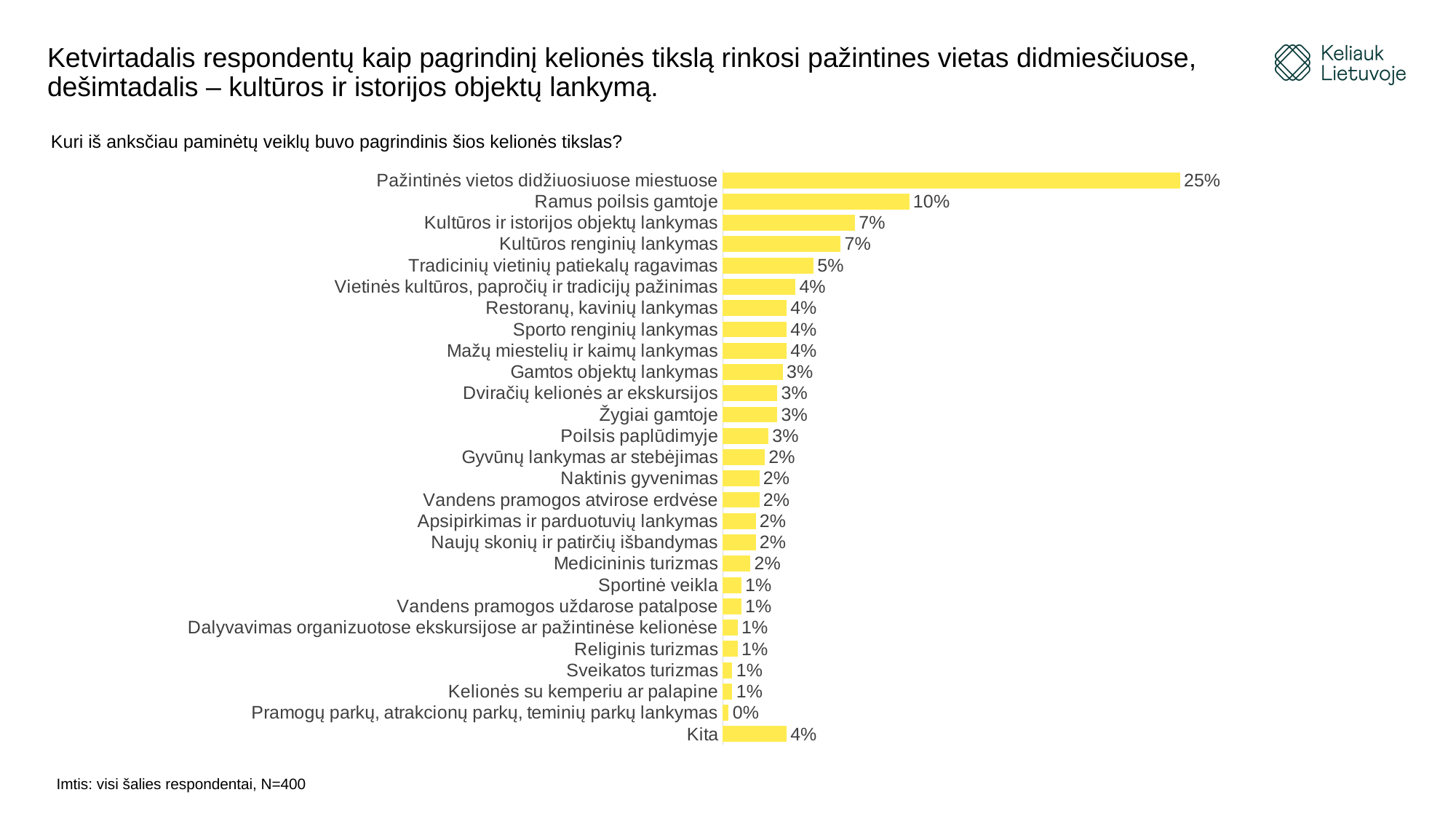
What is the value for Ramus poilsis gamtoje? 10% How many categories are shown in the chart? 27 What is the value for Kita? 4% What is the value for Pažintinės vietos didžiuosiuose miestuose? 25% What is the value for Medicininis turizmas? 2% What is the value for Tradicinių vietinių patiekalų ragavimas? 5% What is the sample size stated below the chart? N=400 Which category has the lowest value? Pramogų parkų, atrakcionų parkų, teminių parkų lankymas What kind of chart is shown on the slide? bar chart Which category has the highest value? Pažintinės vietos didžiuosiuose miestuose What is the difference between the values for Pažintinės vietos didžiuosiuose miestuose and Ramus poilsis gamtoje? 15% Which is larger, the value for Ramus poilsis gamtoje or the value for Kultūros renginių lankymas? Ramus poilsis gamtoje